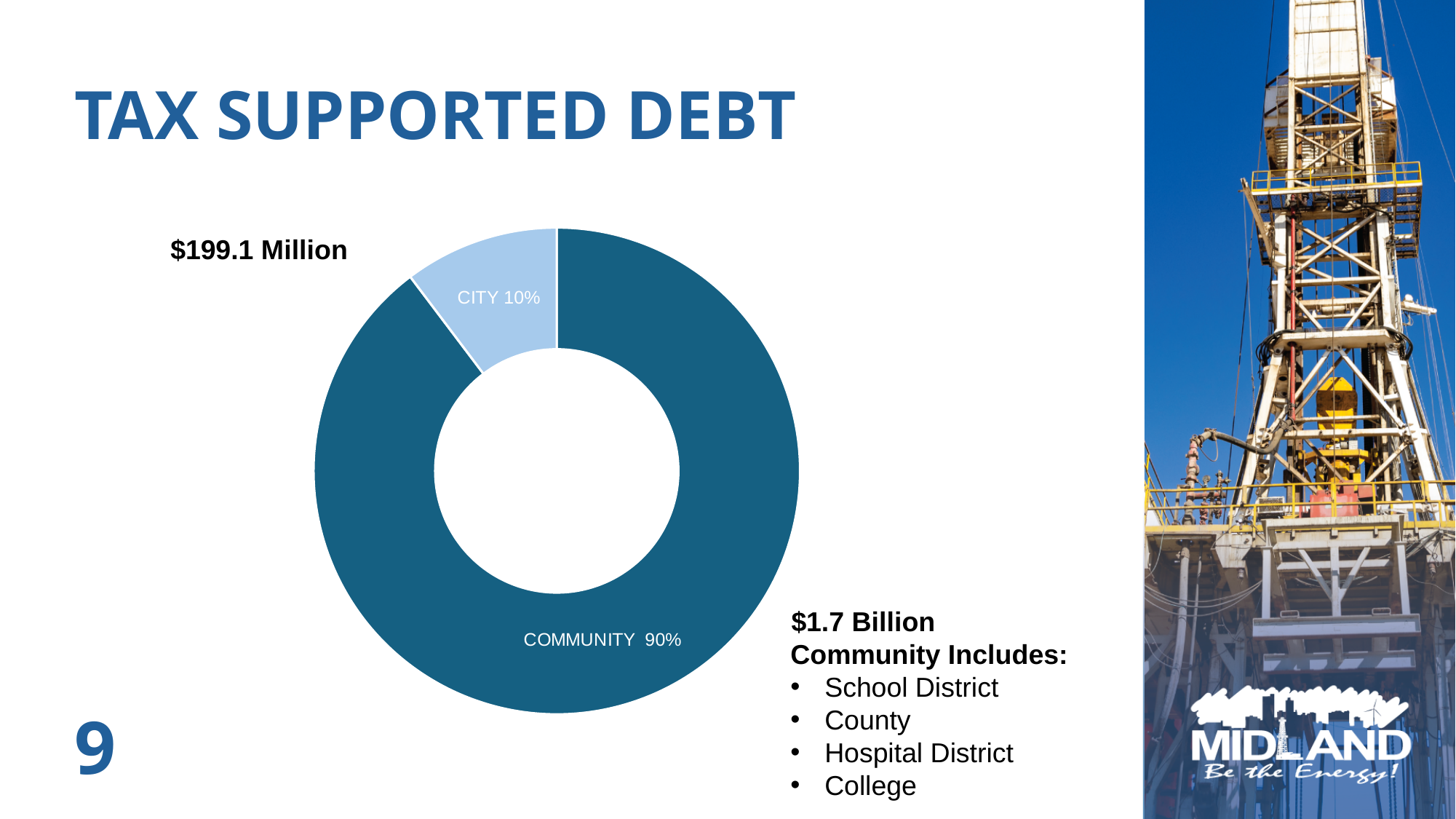
Which slice of the chart is the smallest? City What share of the tax supported debt does the Community slice represent? 90% What is the difference in percentage points between the Community and City slices? 80 percentage points What is the title of the slide containing the chart? TAX SUPPORTED DEBT What dollar amount is labelled next to the Community slice? $1.7 Billion What kind of chart is shown on the slide? Doughnut (pie) chart What share of the tax supported debt does the City slice represent? 10% Which slice is shown in the lighter blue colour? City How many slices does the chart have? 2 Which is larger, the City slice or the Community slice? Community Which slice of the chart is the largest? Community What dollar amount is labelled next to the City slice? $199.1 Million